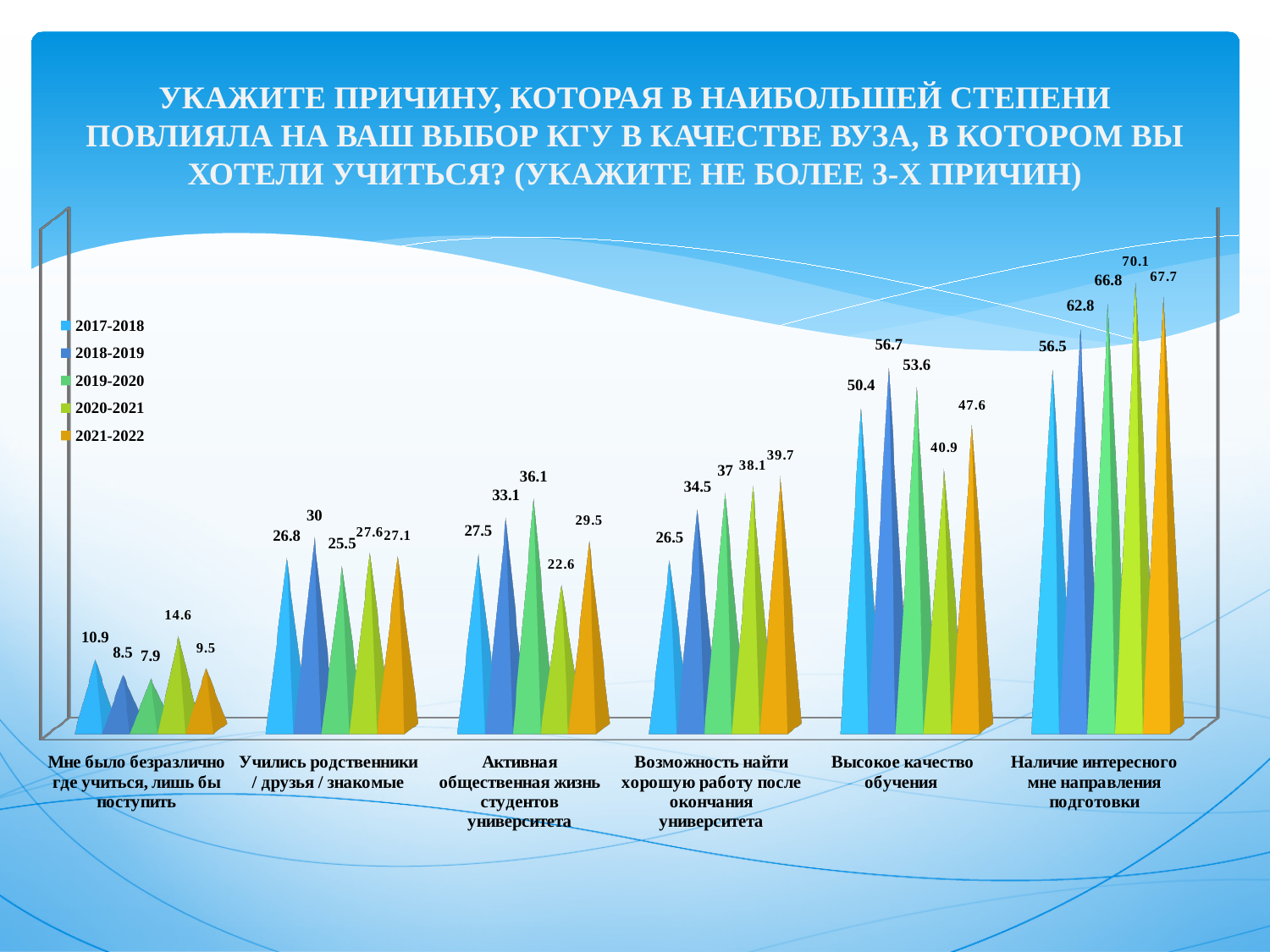
What is the value for 2020-2021 in the category "Наличие интересного мне направления подготовки"? 70.1 What is the value for 2021-2022 in the category "Активная общественная жизнь студентов университета"? 29.5 How many series does the legend list? 5 What is the value for 2017-2018 in the category "Высокое качество обучения"? 50.4 Which category has the highest value for the 2018-2019 series? Наличие интересного мне направления подготовки In the category "Возможность найти хорошую работу после окончания университета", do the values rise or fall from 2017-2018 to 2021-2022? rise What kind of chart is shown on the slide? bar chart What is the difference between the 2020-2021 and 2017-2018 values in the category "Наличие интересного мне направления подготовки"? 13.6 Which series is shown in orange in the legend? 2021-2022 How many categories are shown on the x axis of the chart? 6 Which series has the lowest value in the category "Мне было безразлично где учиться, лишь бы поступить"? 2019-2020 In the category "Высокое качество обучения", which is larger: the value for 2018-2019 or for 2021-2022? 2018-2019